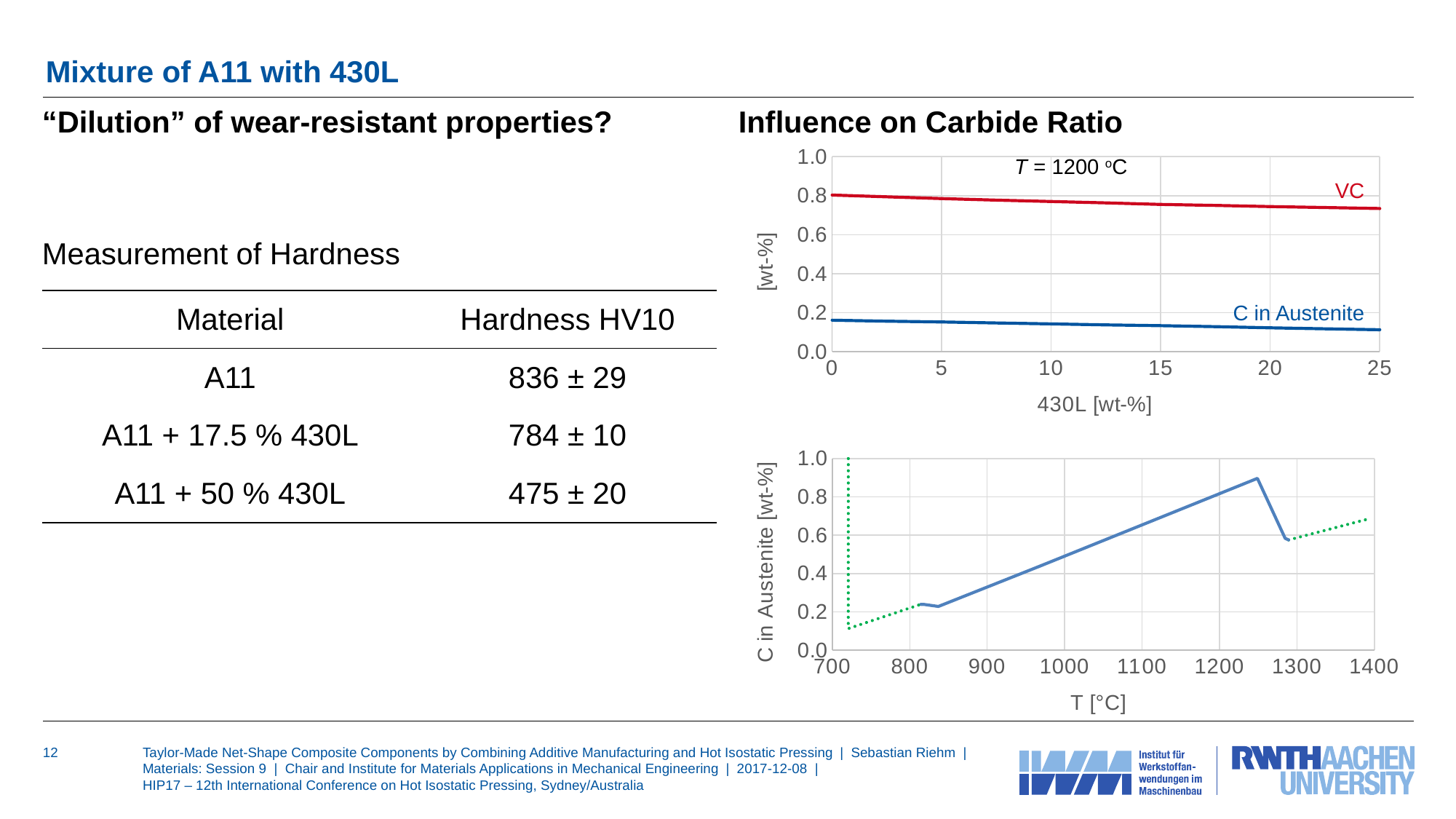
What kind of chart is the bottom chart with T [°C] on the x axis? line chart In the top chart, how many series are plotted? 2 In the bottom chart, is the C in Austenite value at 900 °C greater or less than 0.4? less In the bottom chart, is the C in Austenite value at 1200 °C greater or less than 0.6? greater In the top chart, is the VC value at 0 wt-% 430L greater or less than 0.6? greater In the top chart, which series has the higher values, VC or C in Austenite? VC In the top chart, what are the two series labelled? VC and C in Austenite In the top chart, does the VC line rise or fall as 430L [wt-%] increases from 0 to 25? fall In the bottom chart, does the solid line rise or fall between 900 °C and 1200 °C? rise In the top chart, what temperature is given in the annotation? T = 1200 °C What kind of chart is the top chart titled 'Influence on Carbide Ratio'? line chart